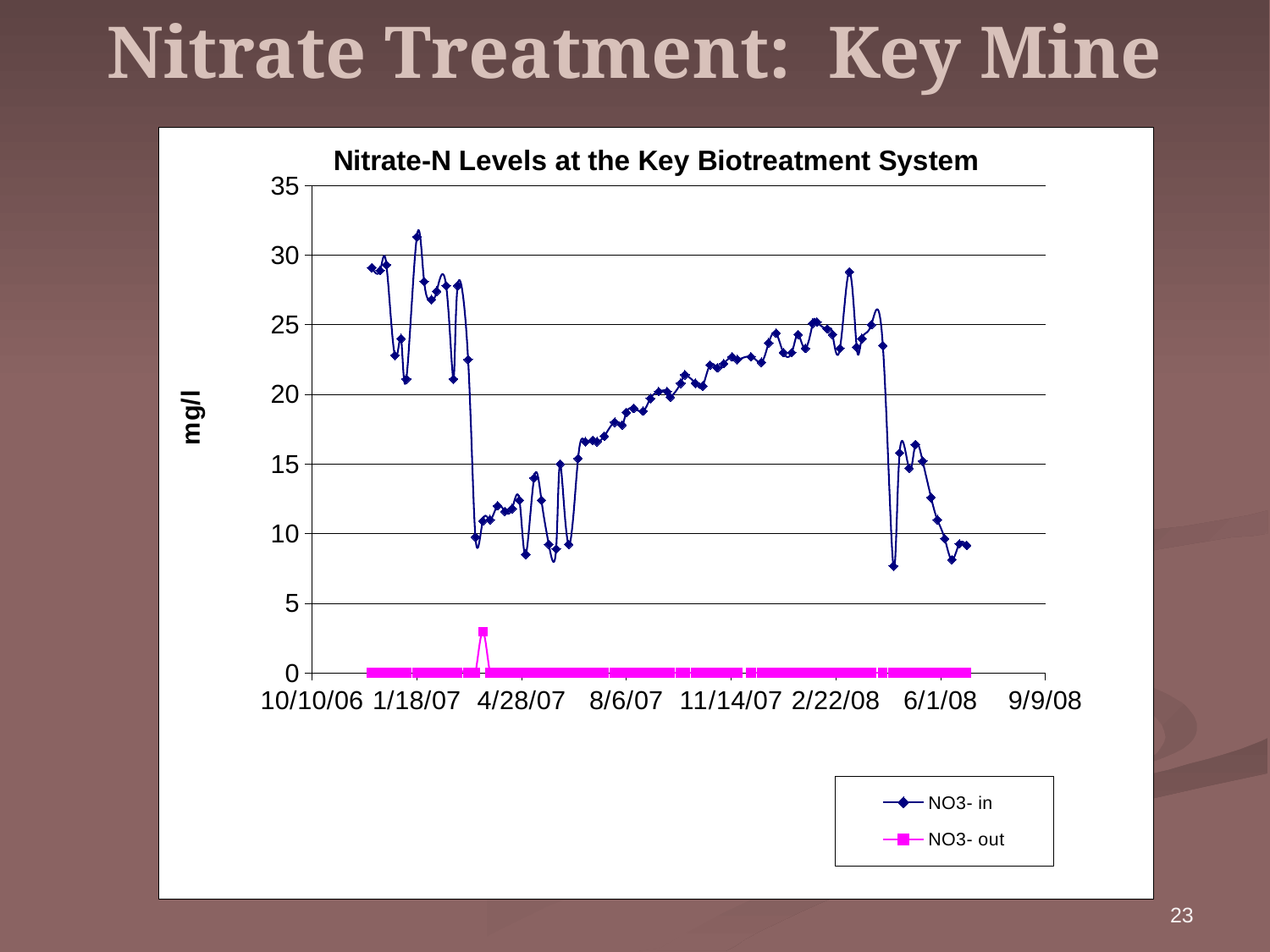
Do the NO3- in values rise or fall between 4/28/07 and 11/14/07? rise Is the value for NO3- in around 1/18/07 greater or less than 25? greater Is the value for NO3- in around 11/14/07 greater or less than 20? greater What kind of chart is shown on the slide? line chart How many series does the legend list? 2 Which series has the higher values throughout the chart, NO3- in or NO3- out? NO3- in Is the highest value for NO3- out greater or less than 5? less What is the title of the chart? Nitrate-N Levels at the Key Biotreatment System Do the NO3- in values rise or fall between 1/18/07 and 4/28/07? fall What is the label on the y axis? mg/l